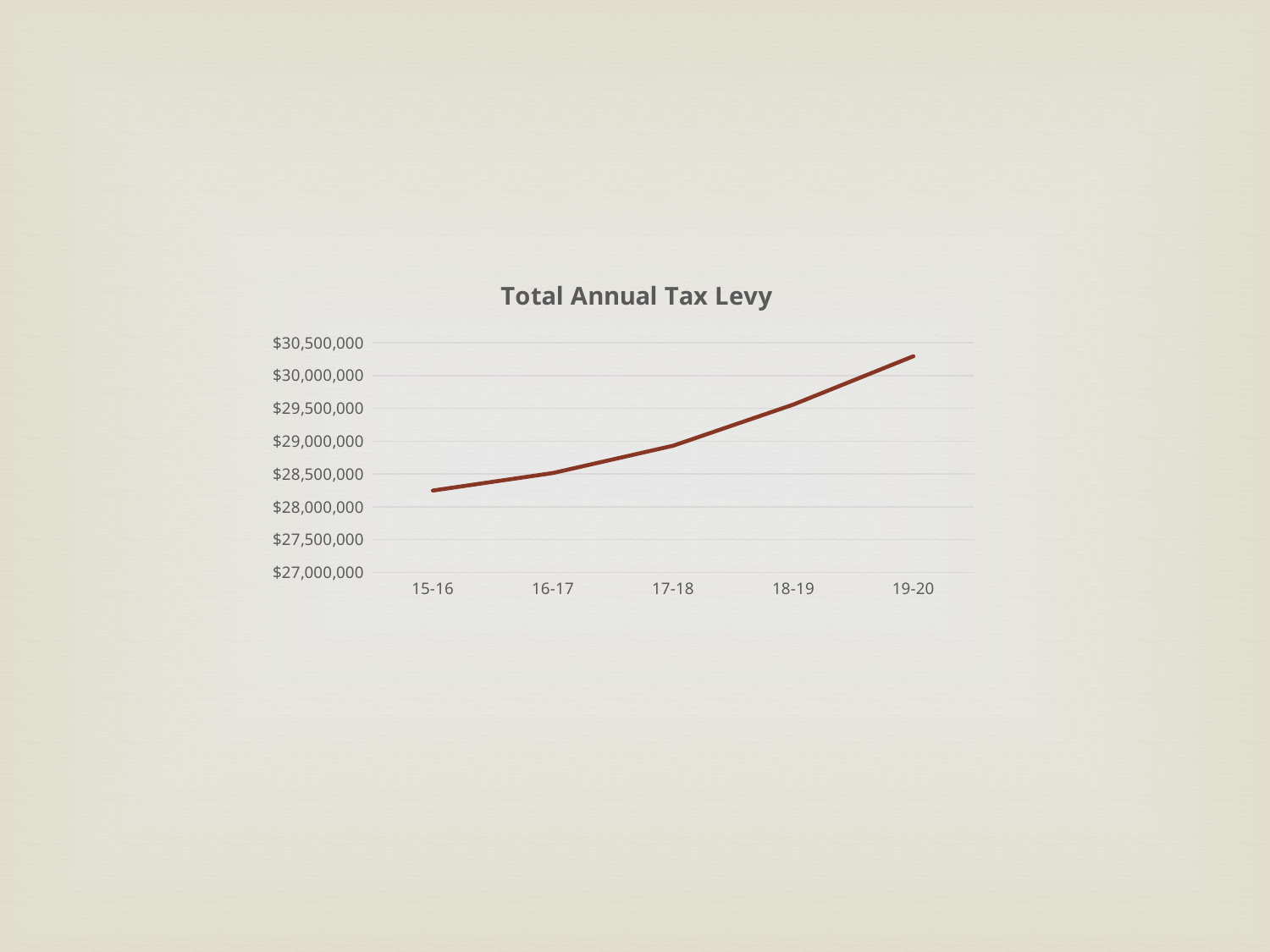
Is the value for 19-20 greater or less than $30,000,000? greater Does the total annual tax levy rise or fall from 15-16 to 19-20? rise Is the value for 17-18 greater or less than $28,500,000? greater Is the value for 19-20 greater or less than $30,500,000? less Which is larger, the value for 18-19 or the value for 16-17? 18-19 How many fiscal years are plotted on the x axis? 5 Which year has the lowest total annual tax levy? 15-16 Which year has the highest total annual tax levy? 19-20 What is the lowest value shown on the y axis? $27,000,000 What kind of chart is shown on the slide? line chart What is the title of the chart? Total Annual Tax Levy